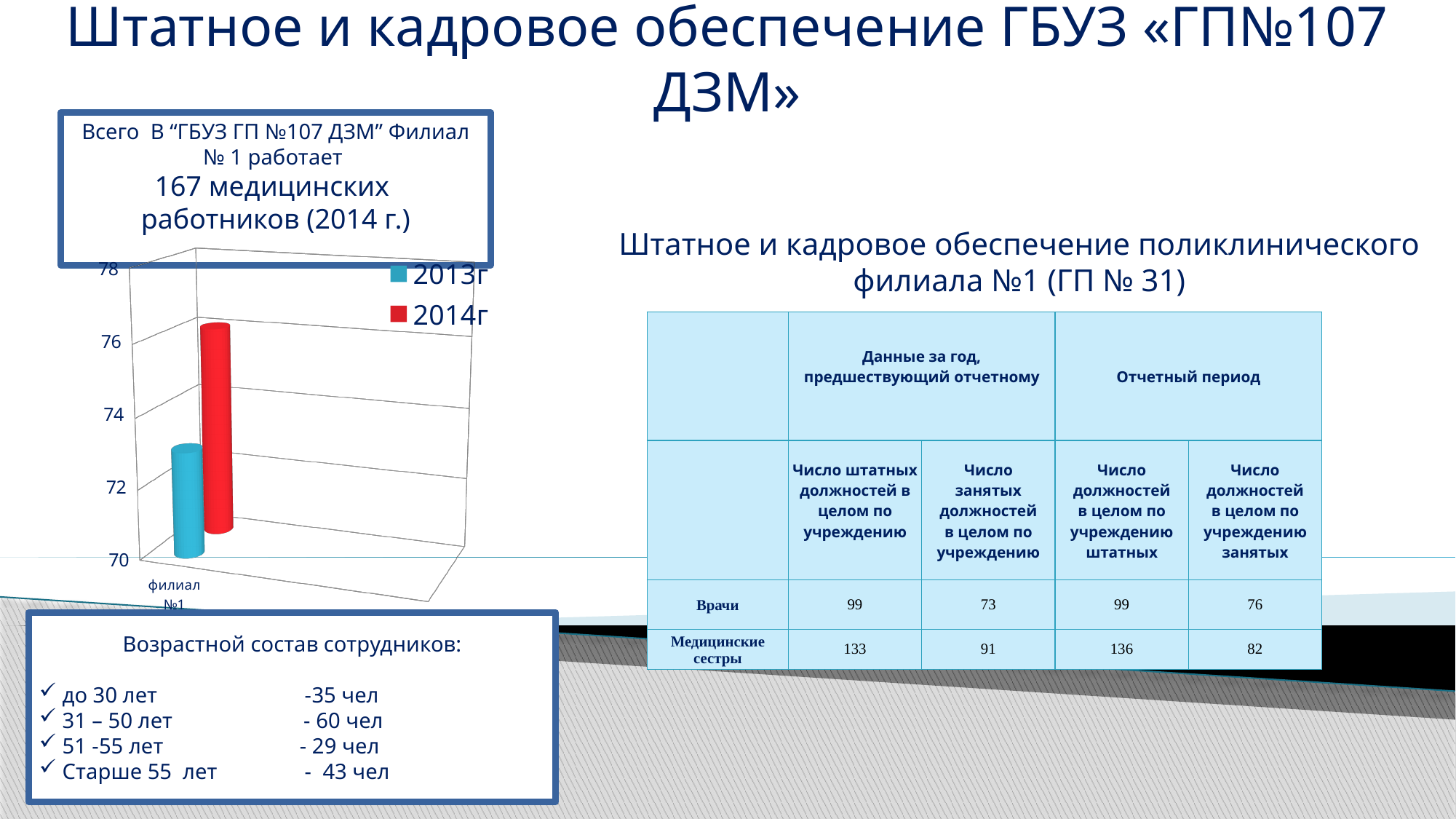
How many series does the legend of the bar chart list? 2 In the bar chart, which series has the taller bar for филиал №1, 2013г or 2014г? 2014г In the bar chart, is the value for 2014г greater or less than 78? less In the bar chart, is the value for 2014г greater or less than 74? greater What is the category label on the x axis of the bar chart? филиал №1 In the bar chart, is the value for 2013г greater or less than 72? greater In the bar chart, which series has the lowest value for филиал №1? 2013г How many categories are shown on the x axis of the bar chart? 1 What kind of chart is shown on the left of the slide? bar chart What are the series names in the legend of the bar chart? 2013г, 2014г